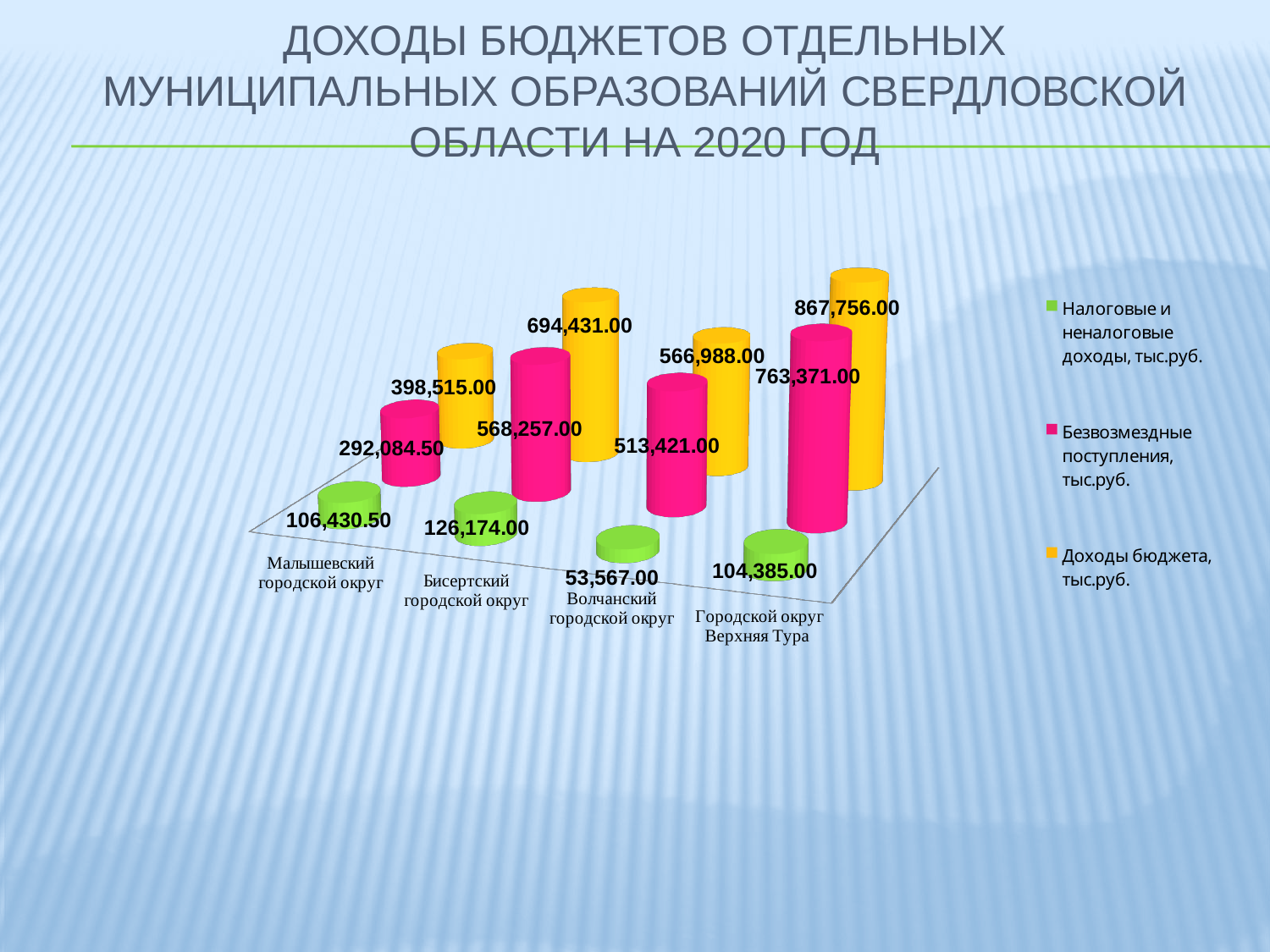
What is the value of Налоговые и неналоговые доходы, тыс.руб. for Малышевский городской округ? 106,430.50 What is the value of Безвозмездные поступления, тыс.руб. for Волчанский городской округ? 513,421.00 What is the value of Доходы бюджета, тыс.руб. for Бисертский городской округ? 694,431.00 Which municipality has the highest Доходы бюджета, тыс.руб.? Городской округ Верхняя Тура Which municipality has the lowest Налоговые и неналоговые доходы, тыс.руб.? Волчанский городской округ What is the value of Доходы бюджета, тыс.руб. for Городской округ Верхняя Тура? 867,756.00 What is the difference between Доходы бюджета and Безвозмездные поступления for Городской округ Верхняя Тура? 104,385.00 How many series does the legend list? 3 What is the difference in Налоговые и неналоговые доходы between Бисертский городской округ and Малышевский городской округ? 19,743.50 Which is larger: Безвозмездные поступления for Бисертский городской округ or for Волчанский городской округ? Бисертский городской округ How many municipalities are shown on the chart? 4 What kind of chart is shown on the slide? Bar chart